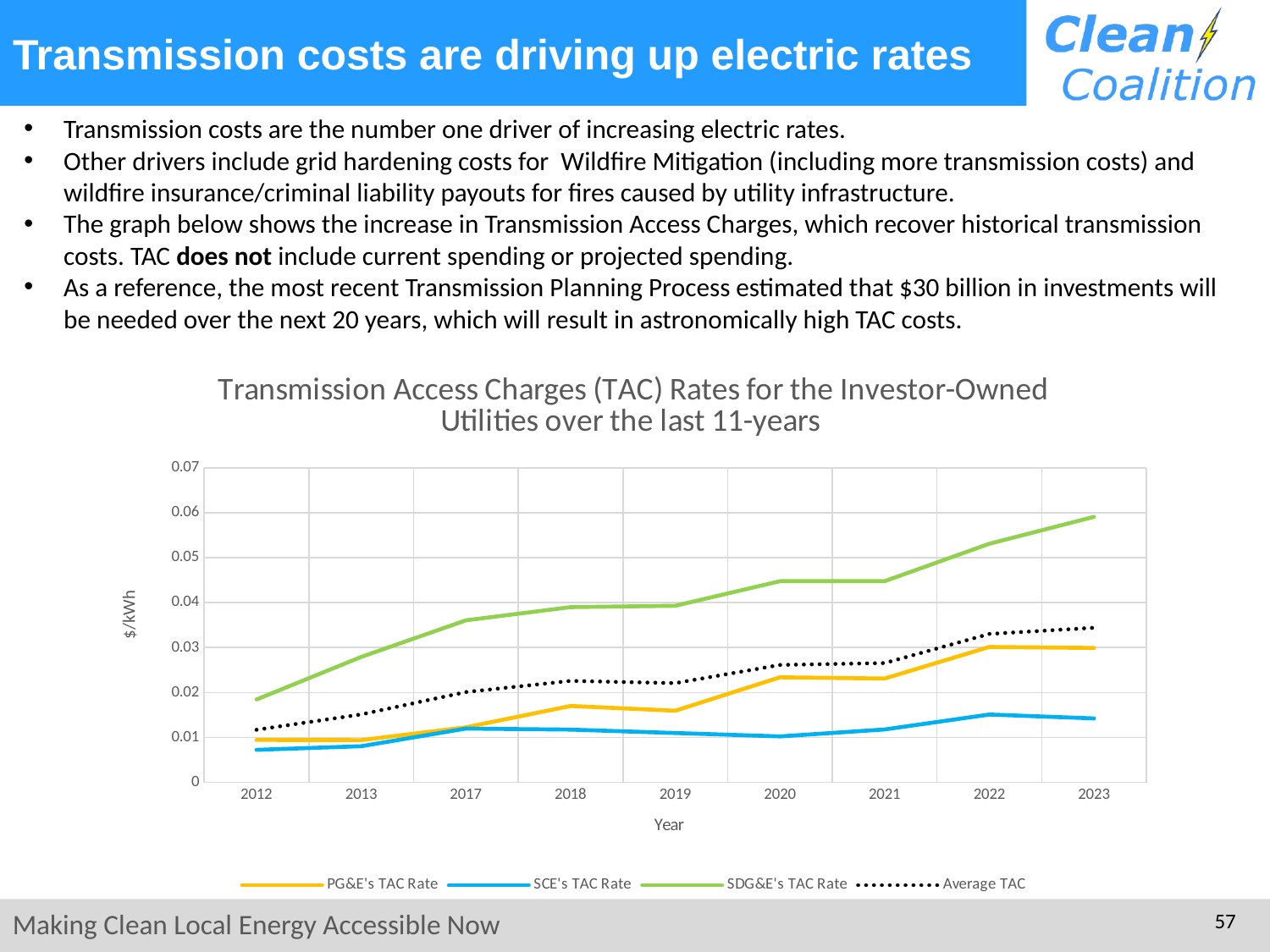
Is the value for SCE's TAC Rate in 2023 greater or less than 0.02? less What kind of chart is shown on the slide? line chart How many series does the chart legend list? 4 Which series has the lowest value in 2023? SCE's TAC Rate What is the label on the y axis of the chart? $/kWh Is the value for SDG&E's TAC Rate in 2023 greater or less than 0.05? greater Which series is drawn as a dotted line in the chart? Average TAC In 2020, which is larger: SDG&E's TAC Rate or PG&E's TAC Rate? SDG&E's TAC Rate Is the value for SDG&E's TAC Rate in 2012 greater or less than 0.02? less Does SDG&E's TAC Rate rise or fall from 2012 to 2023? rise How many years are plotted along the x axis of the chart? 9 Which series has the highest value in 2023? SDG&E's TAC Rate